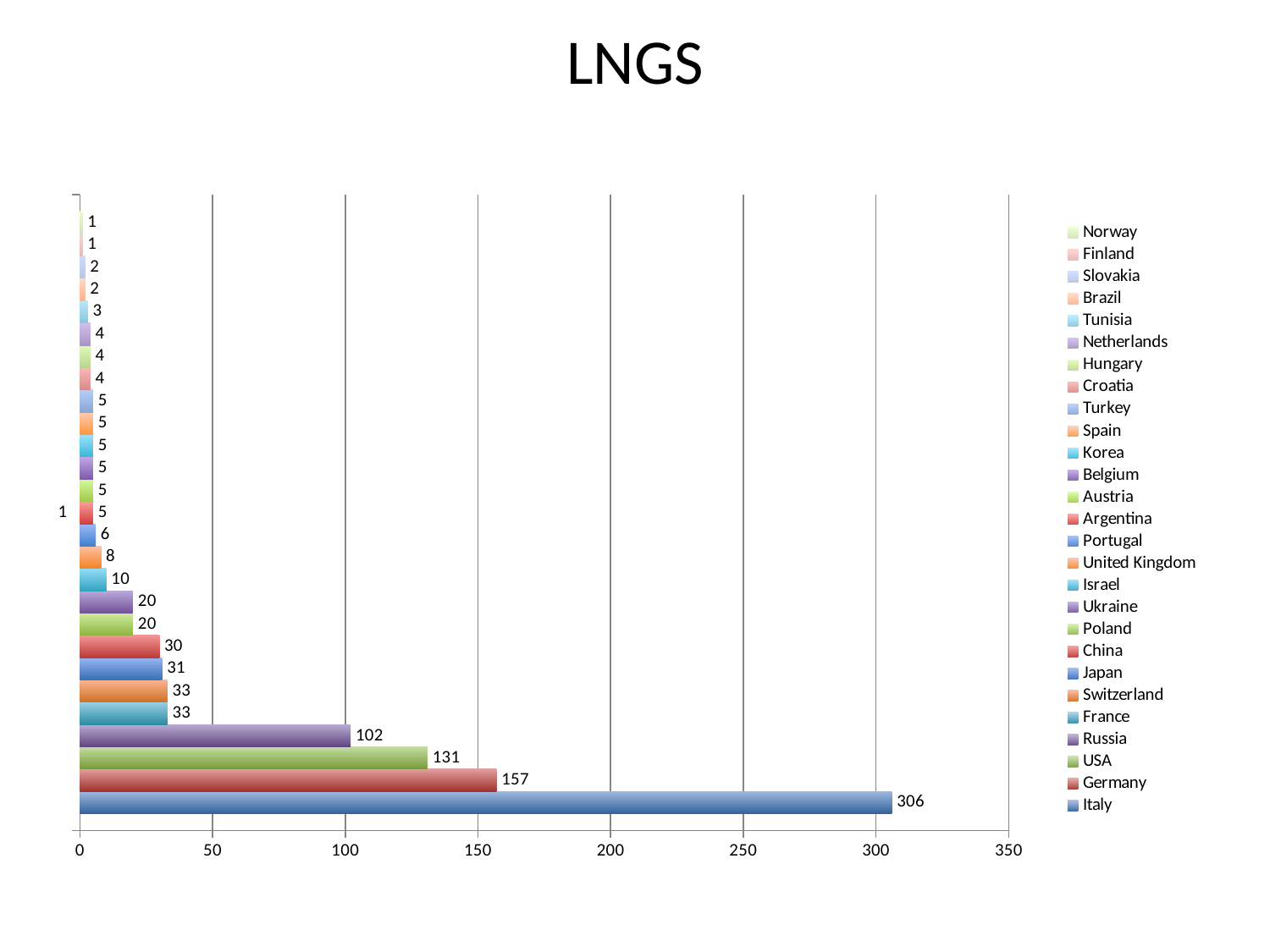
How many countries does the legend list? 27 Which is larger, the value for USA or the value for Russia? USA Is the value for Italy greater or less than 300? greater What is the title of the chart? LNGS What kind of chart is shown on the slide? Bar chart What is the difference between the values for Italy and Germany? 149 What is the value for Russia? 102 What is the value for Germany? 157 What is the value for Italy? 306 What is the difference between the values for Germany and USA? 26 Which country has the highest value? Italy What is the value for Japan? 31